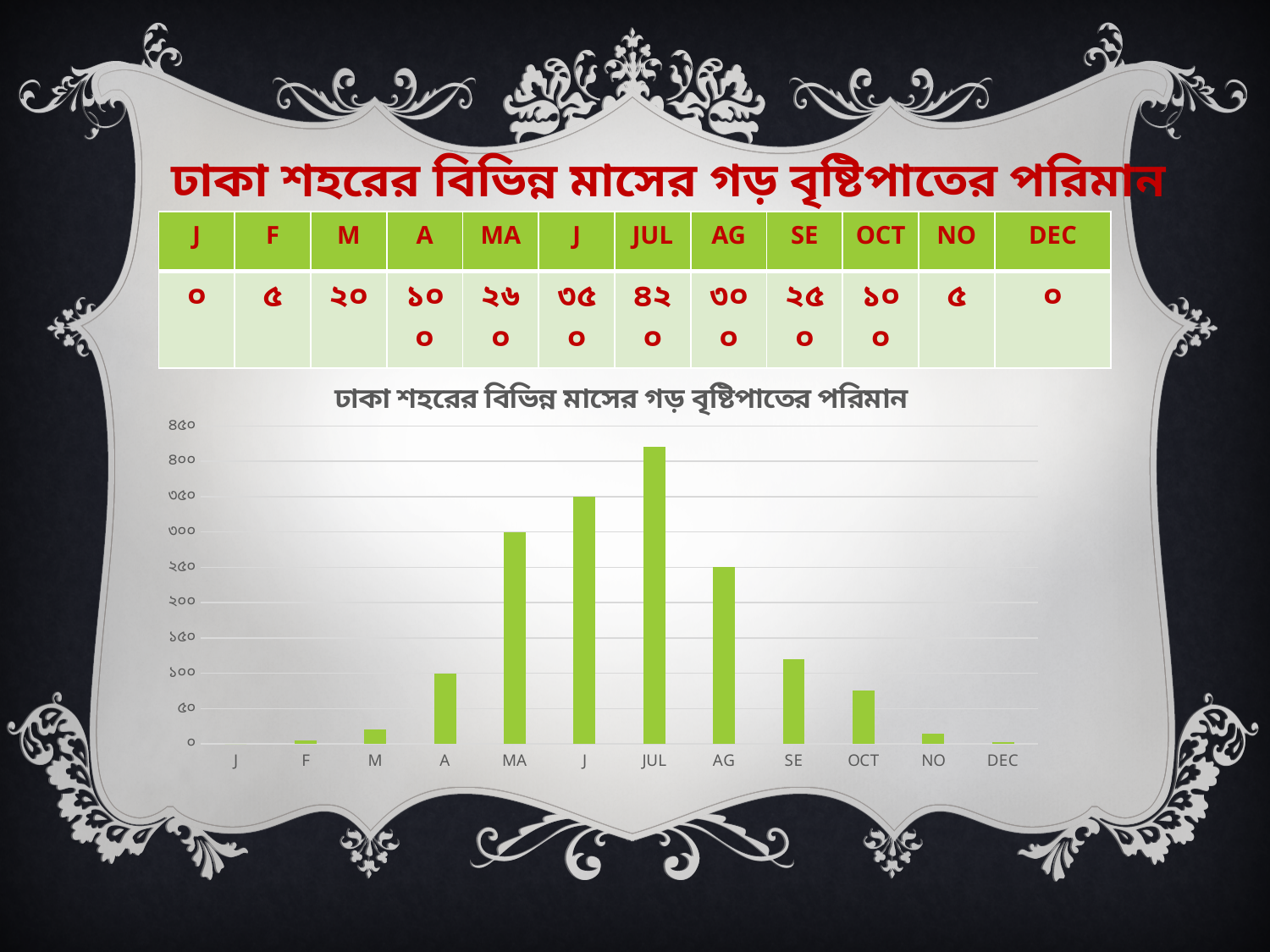
Do the bar values rise or fall from JUL to DEC along the x axis? fall What value does the bar for A reach on the axis? ১০০ Is the value for SE greater or less than ১০০? greater Is the value for NO greater or less than ৫০? less What kind of chart is shown on the slide? bar chart How many months (categories) are plotted on the x axis of the chart? 12 Is the value for JUL greater or less than ৪০০? greater What value does the bar for MA reach on the axis? ৩০০ What value does the bar for J (June, the sixth bar) reach on the axis? ৩৫০ Which bar is taller, MA or AG? MA Which month has the highest bar in the chart? JUL What colour are the bars in the chart? green